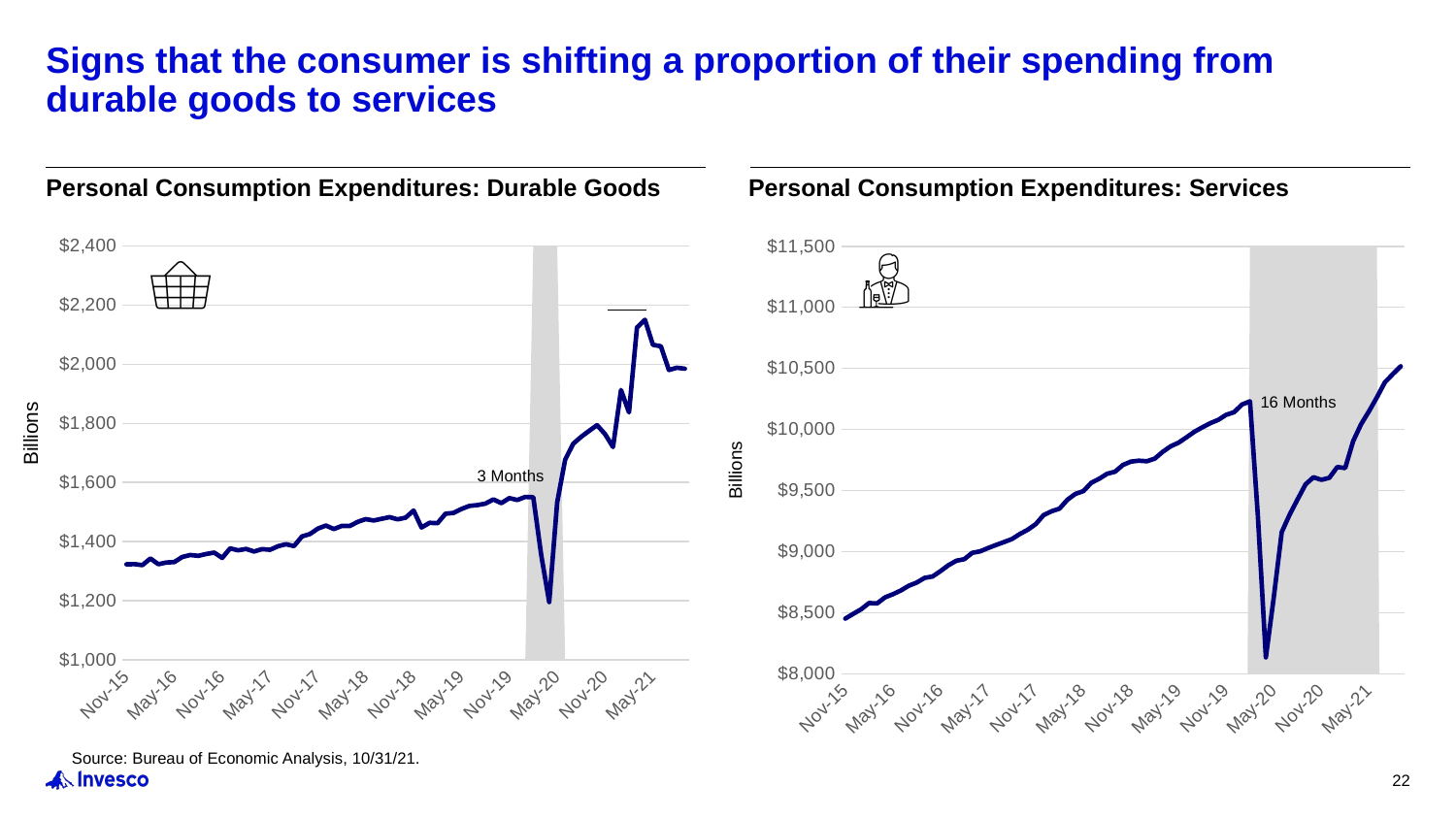
What kind of chart is the 'Personal Consumption Expenditures: Services' chart? Line chart In the Services chart, is the value at May-21 greater or less than $10,000? greater In the Durable Goods chart, do values generally rise or fall from Nov-15 to Nov-19? rise In the Services chart, is the value at Nov-15 greater or less than $9,000? less In the Durable Goods chart, is the peak value reached in 2021 greater or less than $2,000? greater In the Services chart, do values generally rise or fall from Nov-15 to Nov-19? rise What kind of chart is the 'Personal Consumption Expenditures: Durable Goods' chart? Line chart What annotation is shown next to the shaded region in the Services chart? 16 Months What annotation is shown next to the shaded region in the Durable Goods chart? 3 Months How many data series are plotted in the Services chart? 1